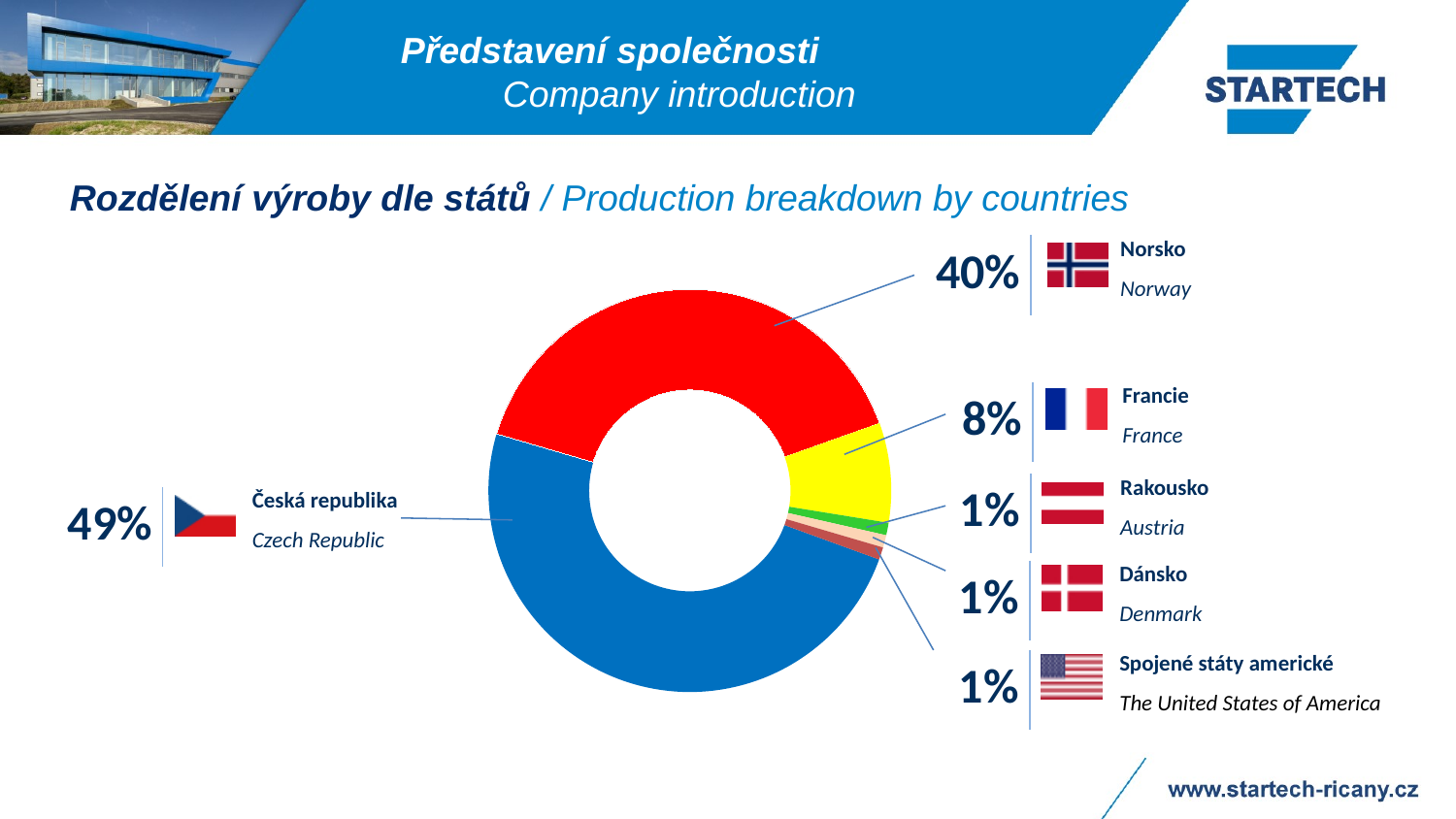
What kind of chart is used to show the production breakdown by countries? Pie chart (doughnut) What is the difference between Norway's share and France's share? 32% How many countries are shown in the production breakdown chart? 6 What share of production does the Czech Republic account for? 49% What share of production does Austria account for? 1% What share of production does France account for? 8% Which has a larger share of production, the Czech Republic or Norway? Czech Republic Which country has the largest share of production? Czech Republic Which has a larger share of production, Norway or France? Norway What colour is the slice representing Norway? Red What is the difference between the Czech Republic's share and Norway's share? 9% What share of production does Norway account for? 40%